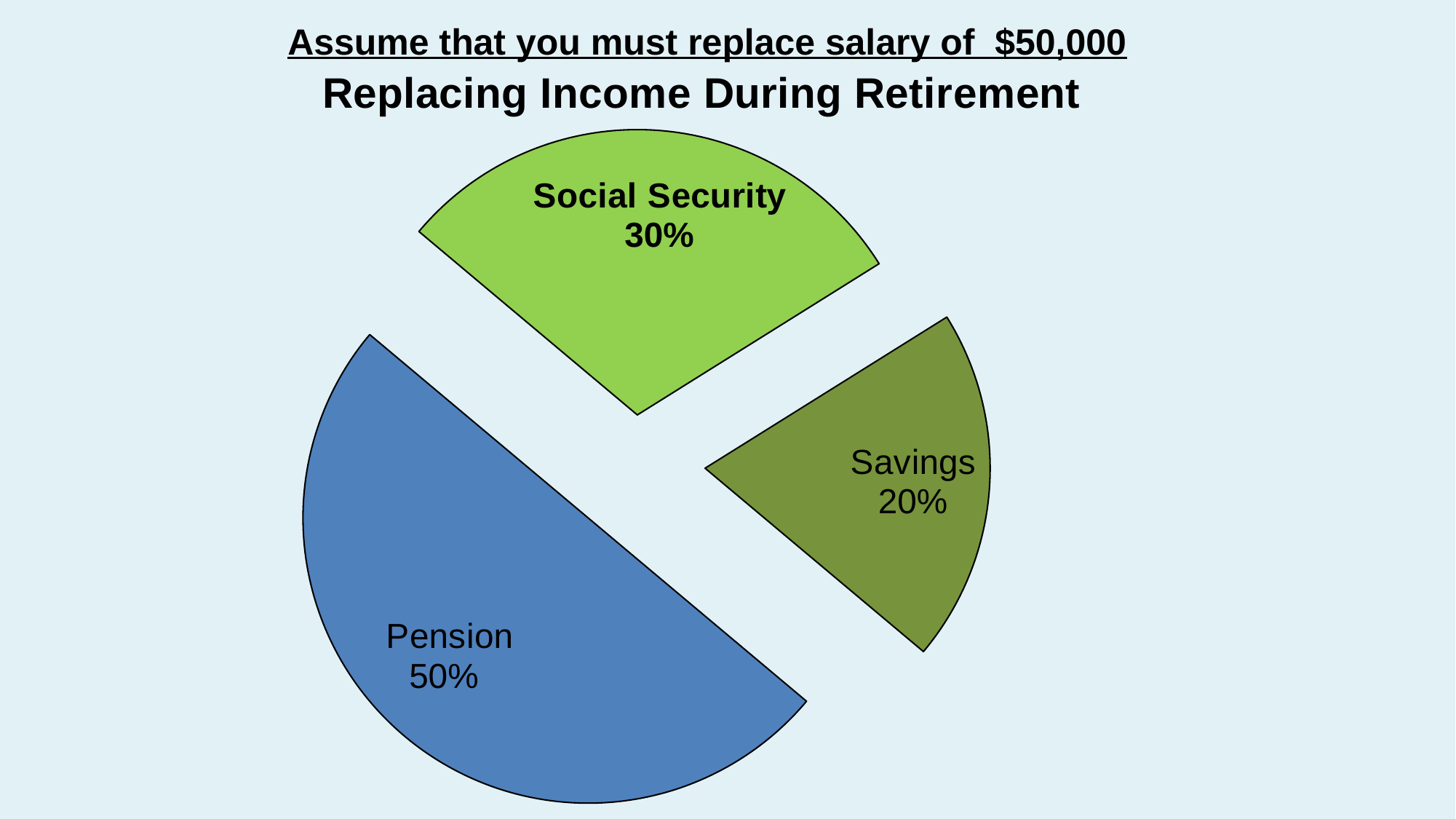
What colour is the Pension slice? Blue What kind of chart is shown on the slide? Pie chart What share of the pie does Savings account for? 20% What share of the pie does Social Security account for? 30% What is the title of the chart? Replacing Income During Retirement Which slice is the smallest? Savings What is the difference in percentage points between Pension and Savings? 30 How many slices does the pie chart have? 3 What is the difference in percentage points between Social Security and Savings? 10 What share of the pie does Pension account for? 50% Which is larger, Social Security or Savings? Social Security Which slice is the largest? Pension